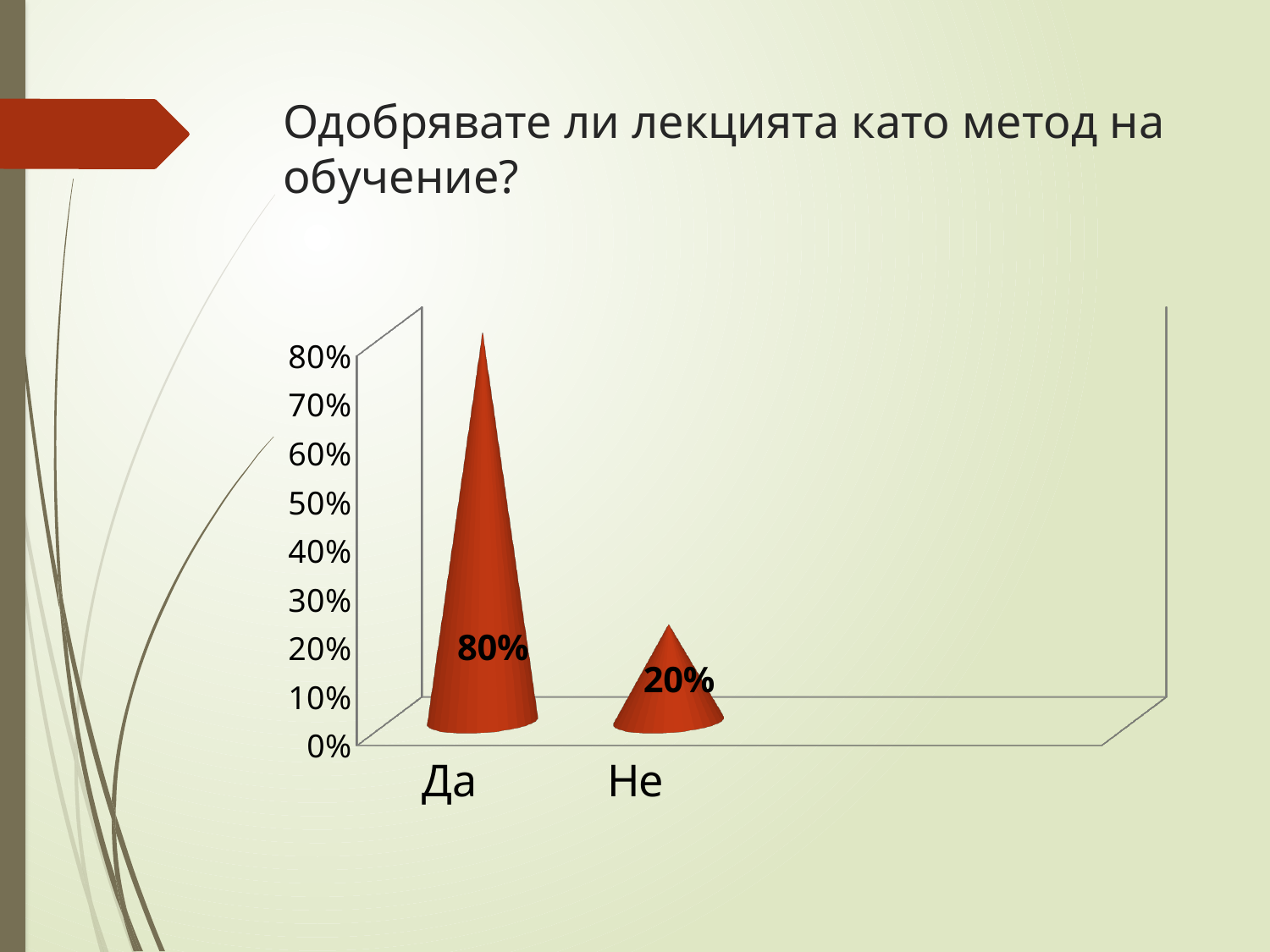
What kind of chart is shown on the slide? bar chart Which is larger, the value for Да or the value for Не? Да What is the title of the slide above the chart? Одобрявате ли лекцията като метод на обучение? Is the value for Не greater or less than 50%? less Is the value for Да greater or less than 50%? greater How many categories are shown on the x axis? 2 What is the value for Не? 20% Which category has the highest value? Да Do the values rise or fall from Да to Не? fall What is the value for Да? 80% Which category has the lowest value? Не What is the difference between the values for Да and Не? 60%